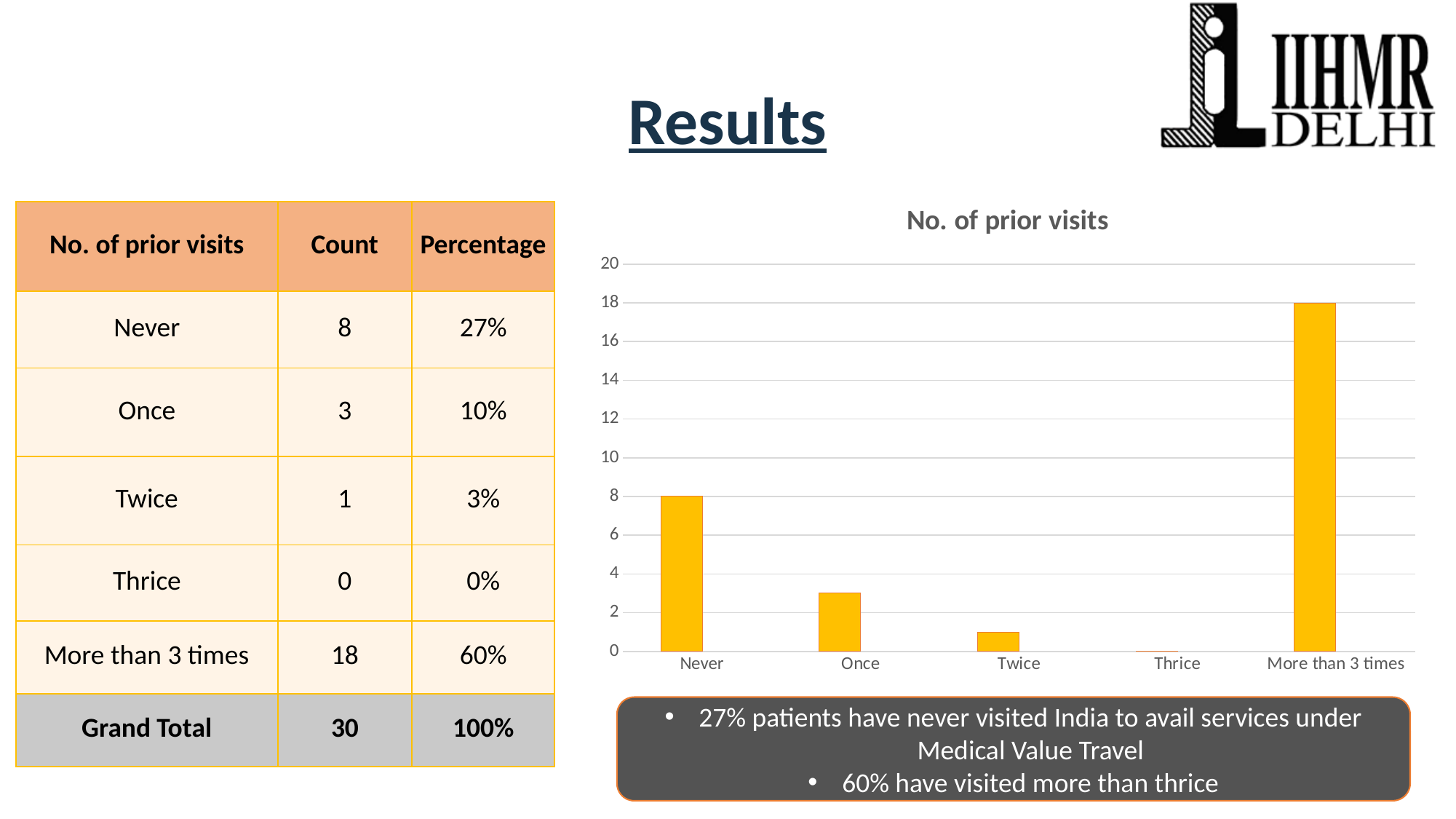
Which is larger in the chart, the value for Once or the value for Twice? Once Which category has the highest value in the chart? More than 3 times What is the value for Thrice in the chart? 0 Is the value for Once greater or less than 4? less What is the value for More than 3 times in the chart? 18 Is the value for More than 3 times greater or less than 16? greater What is the value for Never in the chart? 8 What is the title of the chart? No. of prior visits What is the difference between the values for More than 3 times and Never in the chart? 10 What type of chart is shown on the slide? bar chart Which category has the lowest value in the chart? Thrice How many categories are shown on the x axis of the chart? 5